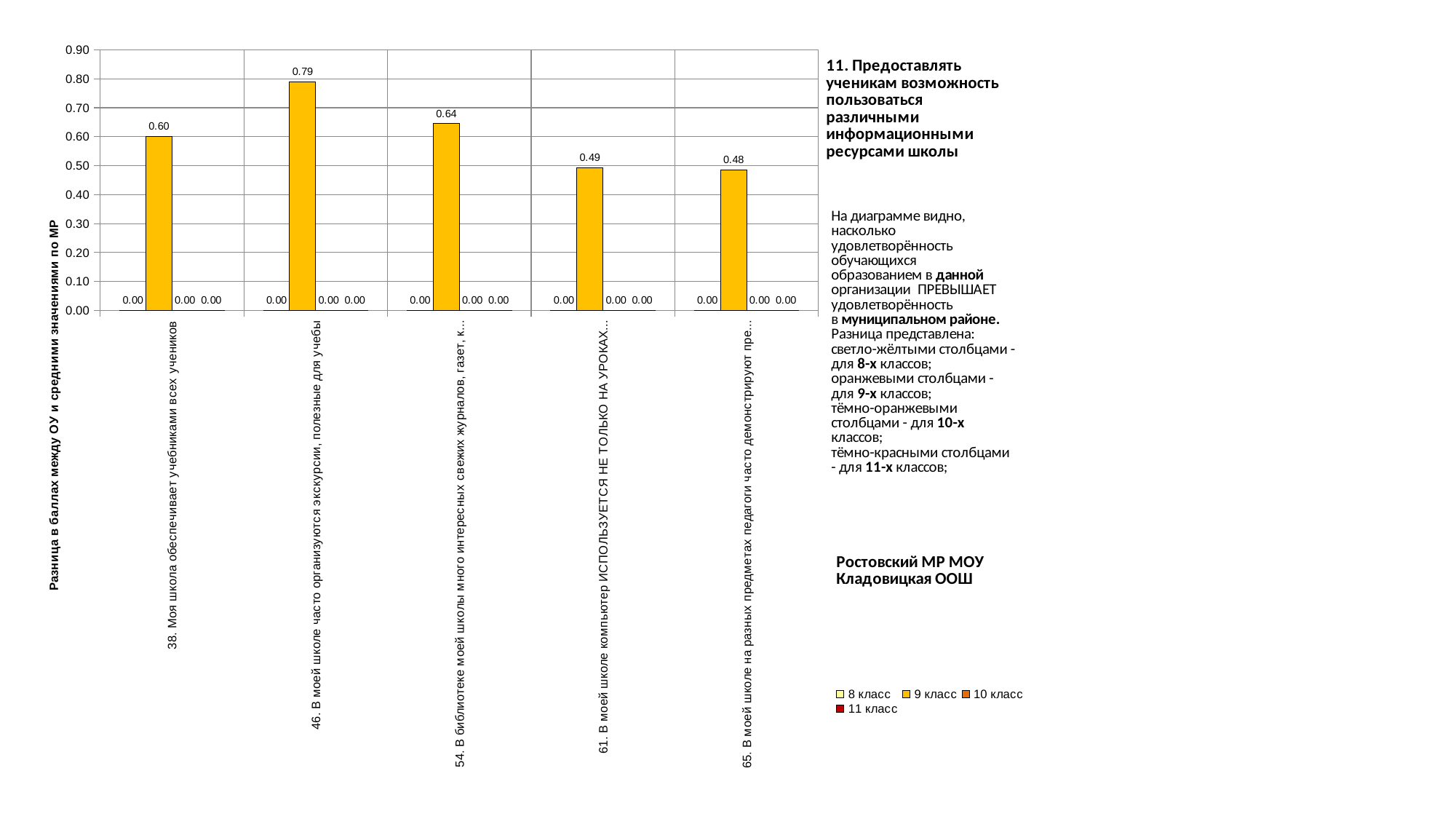
What is the difference between the 9 класс values for category 46 and category 38? 0.19 What is the value for 8 класс in category "54. В библиотеке моей школы много интересных свежих журналов, газет..."? 0.00 What is the value for 9 класс in category "61. В моей школе компьютер ИСПОЛЬЗУЕТСЯ НЕ ТОЛЬКО НА УРОКАХ..."? 0.49 What is the label of the vertical axis? Разница в баллах между ОУ и средними значениями по МР How many categories are shown on the x axis of the chart? 5 What is the value for 9 класс in category "38. Моя школа обеспечивает учебниками всех учеников"? 0.60 How many series does the legend list? 4 What is the value for 9 класс in category "46. В моей школе часто организуются экскурсии, полезные для учебы"? 0.79 Which is larger for 9 класс: the value for category 54 or the value for category 61? category 54 Which category has the highest value for 9 класс? 46. В моей школе часто организуются экскурсии, полезные для учебы What type of chart is shown on the slide? bar chart Which category has the lowest value for 9 класс? 65. В моей школе на разных предметах педагоги часто демонстрируют пре...